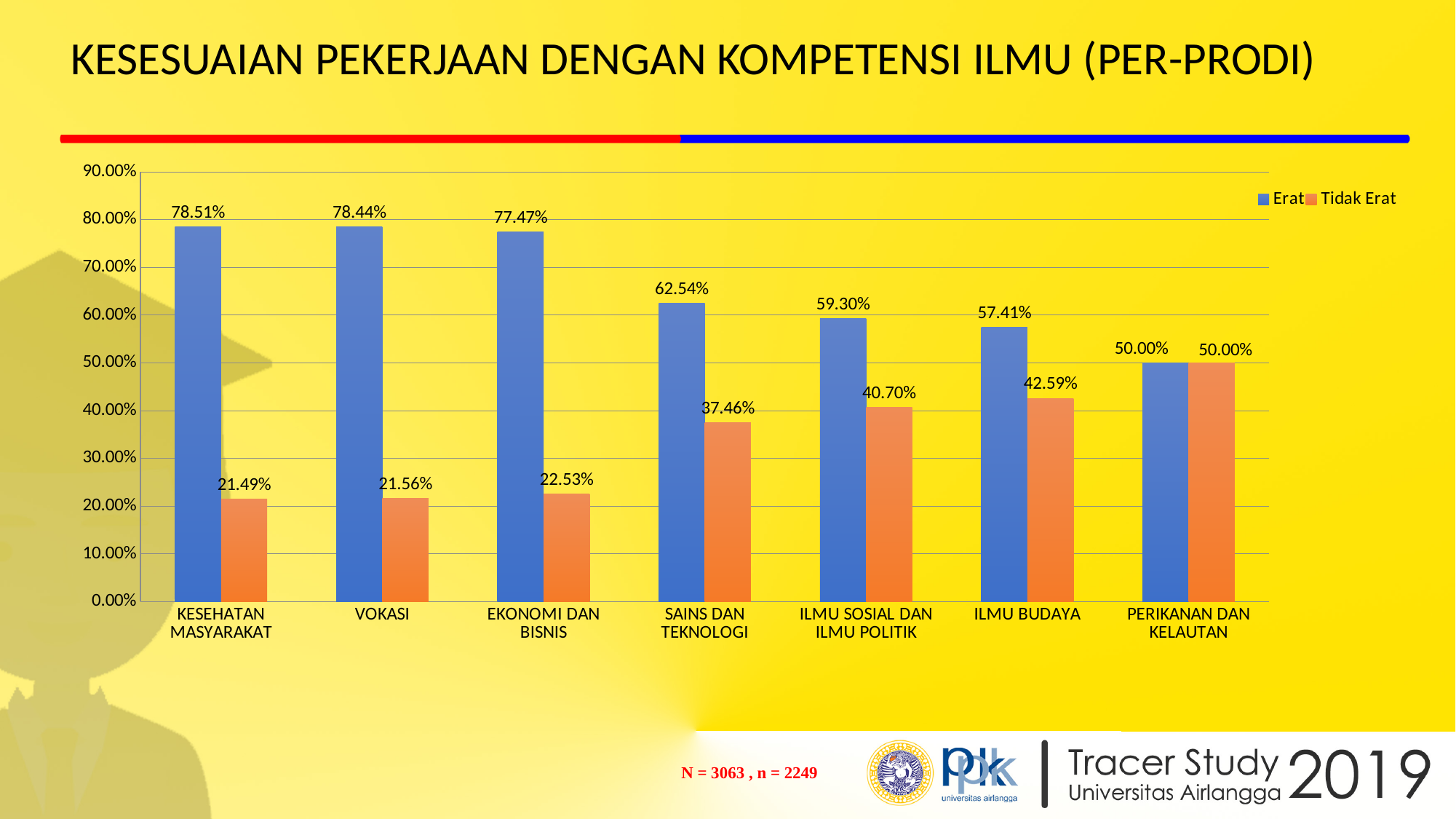
What is the Tidak Erat value for Ilmu Budaya? 42.59% Do the Erat values rise or fall from left to right across the categories? fall Is the Tidak Erat value for Sains dan Teknologi greater or less than 40.00%? less What is the Tidak Erat value for Kesehatan Masyarakat? 21.49% Which category has the lowest Erat value? Perikanan dan Kelautan What is the difference between the Erat values for Ekonomi dan Bisnis and Sains dan Teknologi? 14.93% How many categories (prodi) are shown on the x axis? 7 What is the Erat value for Sains dan Teknologi? 62.54% Which category has the highest Tidak Erat value? Perikanan dan Kelautan How many series does the legend list? 2 What is the difference between the Erat and Tidak Erat values for Sains dan Teknologi? 25.08% For Ilmu Sosial dan Ilmu Politik, which is larger: Erat or Tidak Erat? Erat